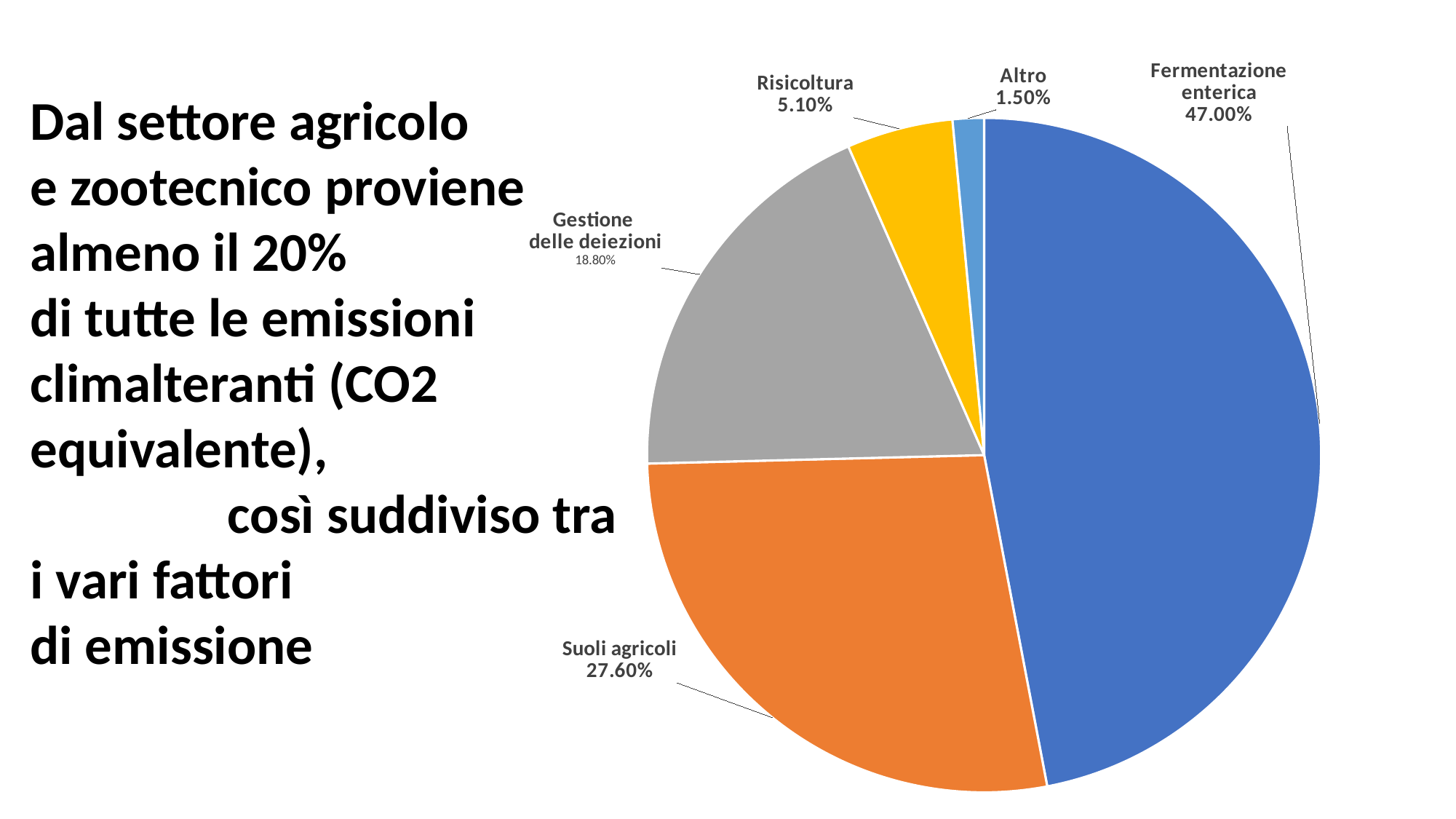
What is the value shown for Gestione delle deiezioni? 18.80% How many slices does the pie chart have? 5 What share of emissions does Fermentazione enterica account for? 47.00% What is the value shown for Risicoltura? 5.10% Which category has the largest slice of the pie? Fermentazione enterica What is the value shown for Suoli agricoli? 27.60% Which category has the smallest slice of the pie? Altro What is the value shown for Altro? 1.50% What colour is the slice for Risicoltura? yellow Which is larger, Suoli agricoli or Gestione delle deiezioni? Suoli agricoli What kind of chart is shown on the slide? pie chart What is the difference between Fermentazione enterica and Suoli agricoli? 19.40%